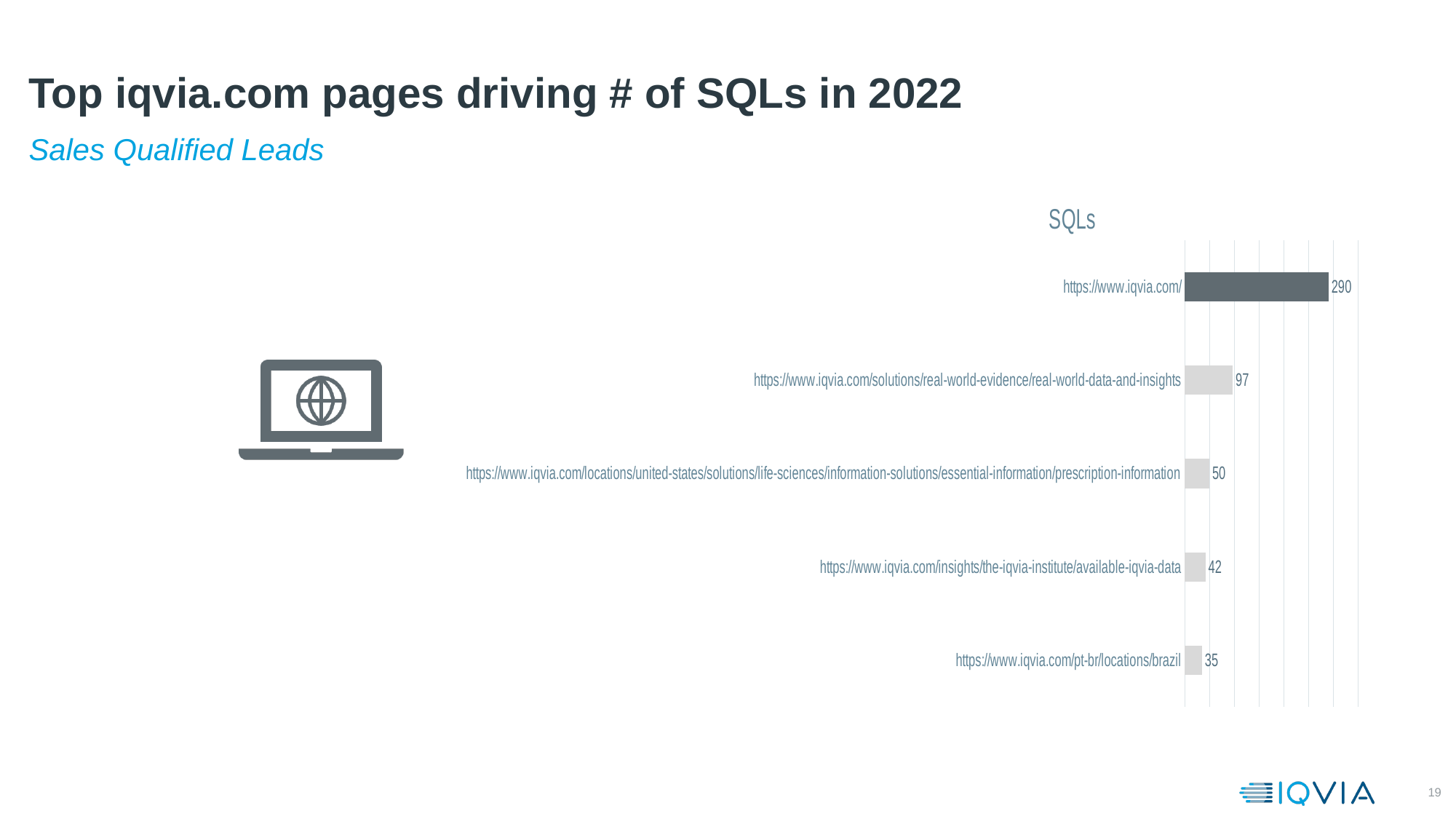
Which page has the lowest number of SQLs? https://www.iqvia.com/pt-br/locations/brazil What is the title of the chart? SQLs What is the difference in SQLs between the prescription-information page and the brazil page? 15 What is the SQLs value for https://www.iqvia.com/insights/the-iqvia-institute/available-iqvia-data? 42 What is the difference in SQLs between https://www.iqvia.com/ and https://www.iqvia.com/solutions/real-world-evidence/real-world-data-and-insights? 193 Which has more SQLs: https://www.iqvia.com/insights/the-iqvia-institute/available-iqvia-data or https://www.iqvia.com/pt-br/locations/brazil? https://www.iqvia.com/insights/the-iqvia-institute/available-iqvia-data What type of chart is shown on the slide? Bar chart What is the SQLs value for https://www.iqvia.com/pt-br/locations/brazil? 35 Which page has the highest number of SQLs? https://www.iqvia.com/ How many pages are shown in the chart? 5 What is the SQLs value for https://www.iqvia.com/? 290 What is the SQLs value for https://www.iqvia.com/solutions/real-world-evidence/real-world-data-and-insights? 97